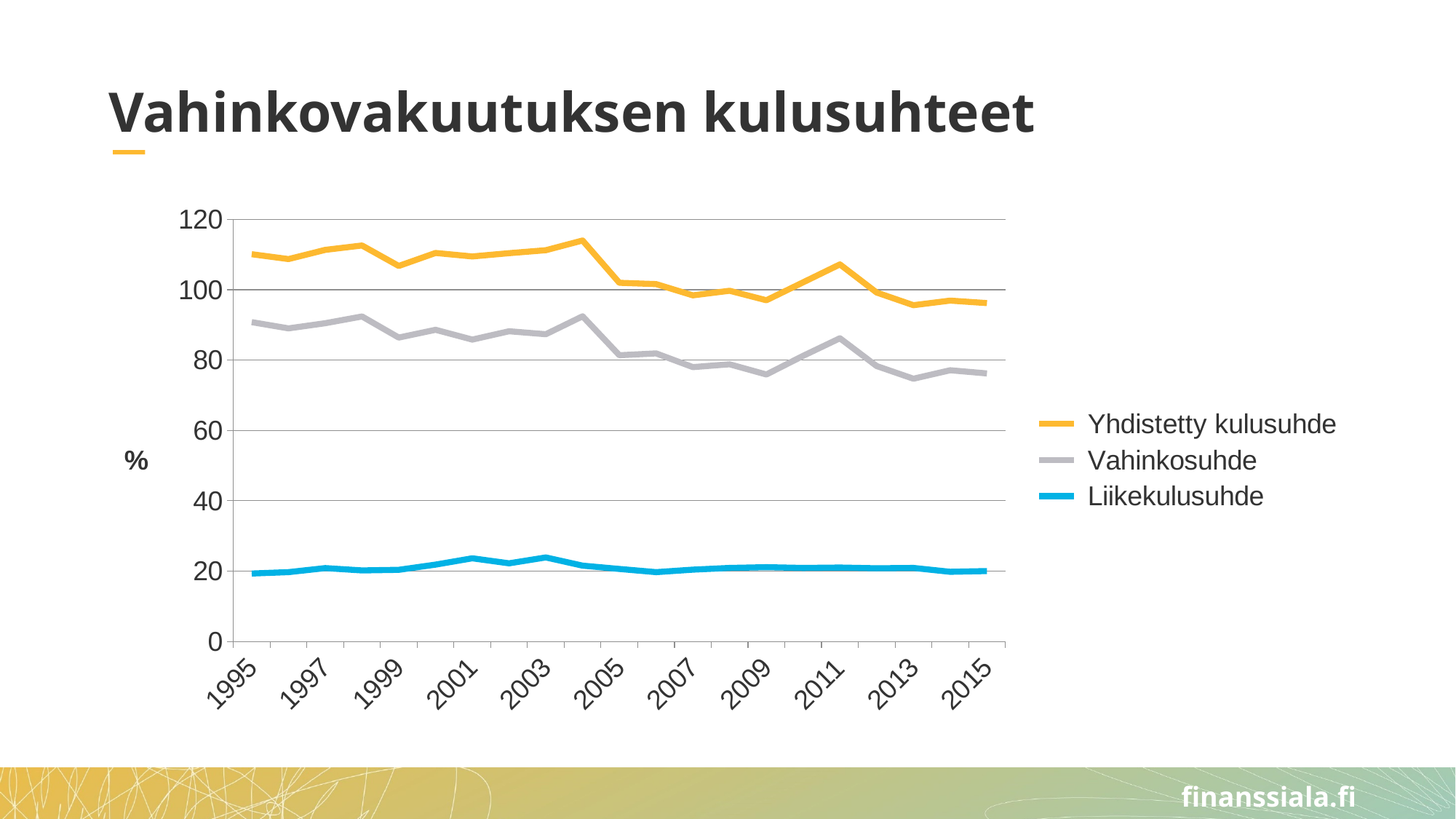
Is the value for Liikekulusuhde in 2015 greater or less than 40? less How many series does the legend list? 3 Is the value for Yhdistetty kulusuhde in 1995 greater or less than 100? greater Is the value for Vahinkosuhde in 2009 greater or less than 80? less In 2005, which is larger: Yhdistetty kulusuhde or Vahinkosuhde? Yhdistetty kulusuhde What kind of chart is shown on the slide? line chart Which series has the lowest values across the whole period? Liikekulusuhde How many years are labeled on the x axis? 11 Does Yhdistetty kulusuhde overall rise or fall from 1995 to 2015? fall Which series has the highest values across the whole period? Yhdistetty kulusuhde